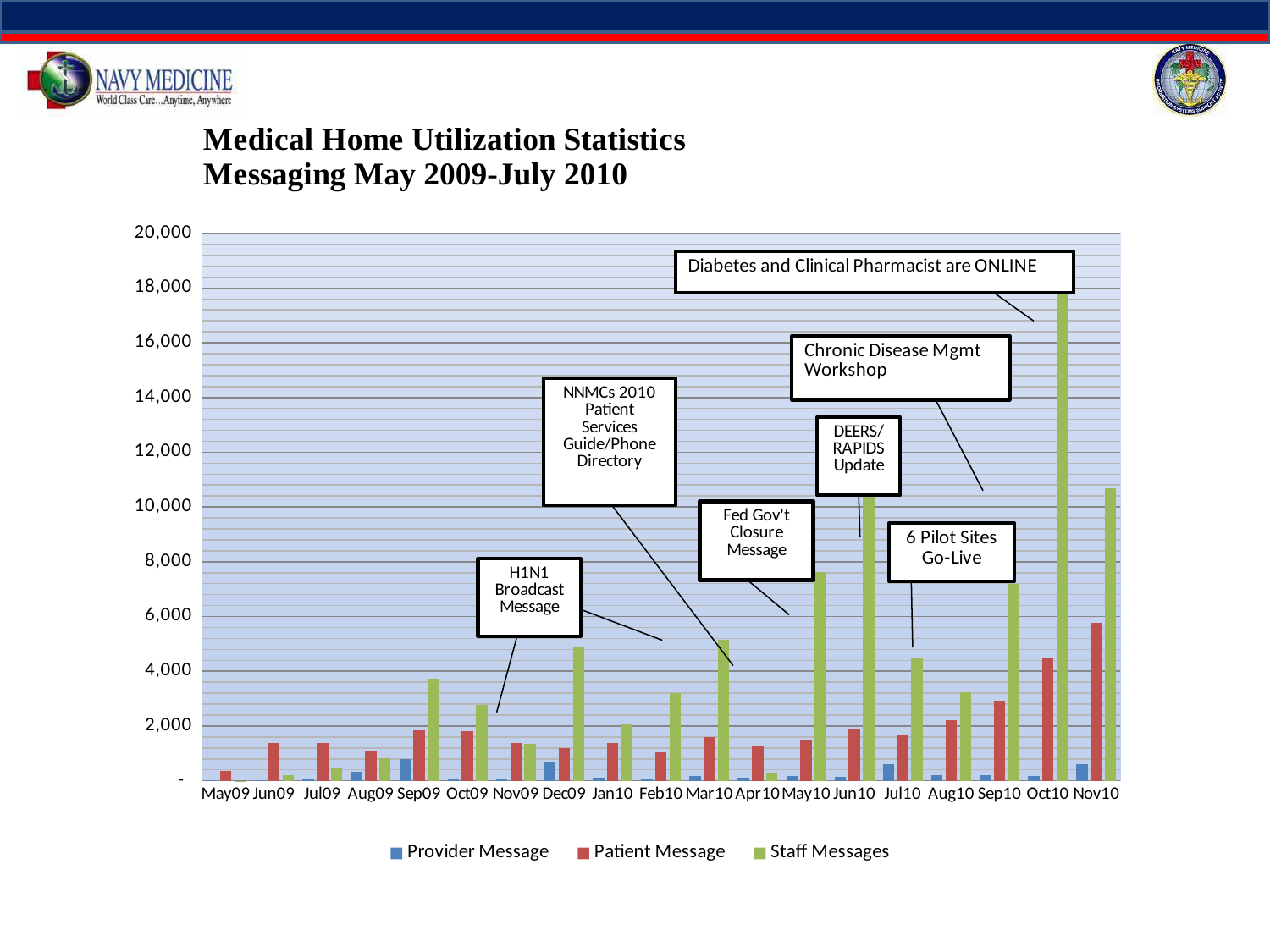
In which month is the Staff Messages value highest? Oct10 Is the Staff Messages value for Oct10 greater or less than 16,000? greater Is the Patient Message value for Nov10 greater or less than 4,000? greater In Oct10, which is larger: Staff Messages or Patient Message? Staff Messages How many series does the legend list? 3 Which series has the lowest value in Nov10? Provider Message What kind of chart is shown on the slide? bar chart Which colour represents Staff Messages in the legend? green Is the Staff Messages value for Nov10 greater or less than 10,000? greater How many months are shown along the x axis? 19 In which month is the Staff Messages value lowest? May09